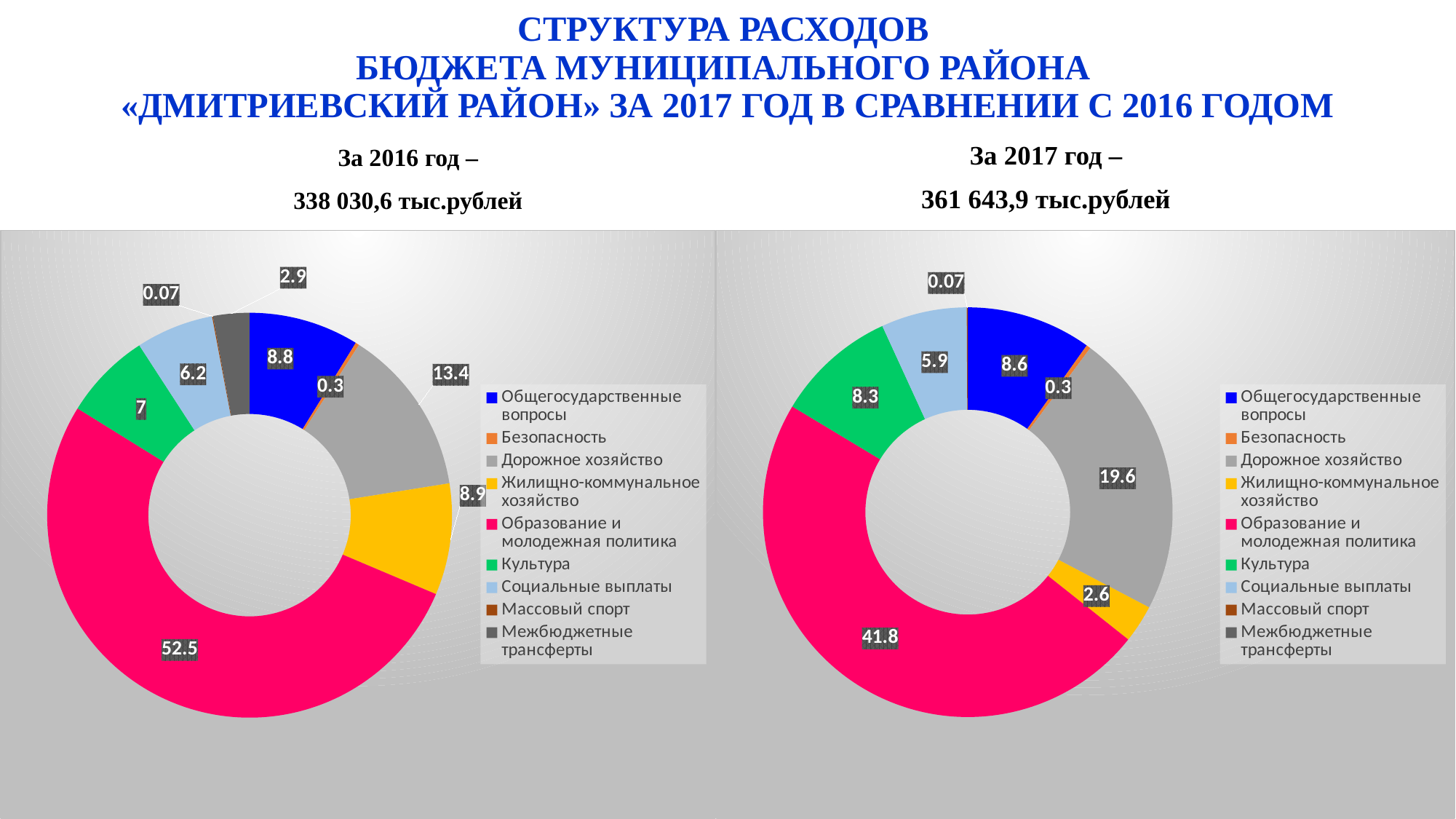
How many categories does the legend of the 2016 chart (left) list? 9 In the 2017 chart (right), what is the value for Дорожное хозяйство? 19.6 In the 2017 chart (right), what is the value for Жилищно-коммунальное хозяйство? 2.6 What type of chart is used on this slide? Doughnut (pie) chart Which is larger: Культура in the 2016 chart or Культура in the 2017 chart? 2017 chart (8.3) What total expenditure is stated for 2017 above the right chart? 361 643,9 тыс.рублей In the 2016 chart (left), what is the value for Социальные выплаты? 6.2 In the 2016 chart (left), which is larger: Общегосударственные вопросы or Жилищно-коммунальное хозяйство? Жилищно-коммунальное хозяйство In the 2017 chart (right), which labelled category has the smallest value? Массовый спорт What is the difference between the Дорожное хозяйство value in the 2017 chart and in the 2016 chart? 6.2 In the 2016 chart (left), which category has the largest share? Образование и молодежная политика In the 2016 chart (left), what is the value for Образование и молодежная политика? 52.5